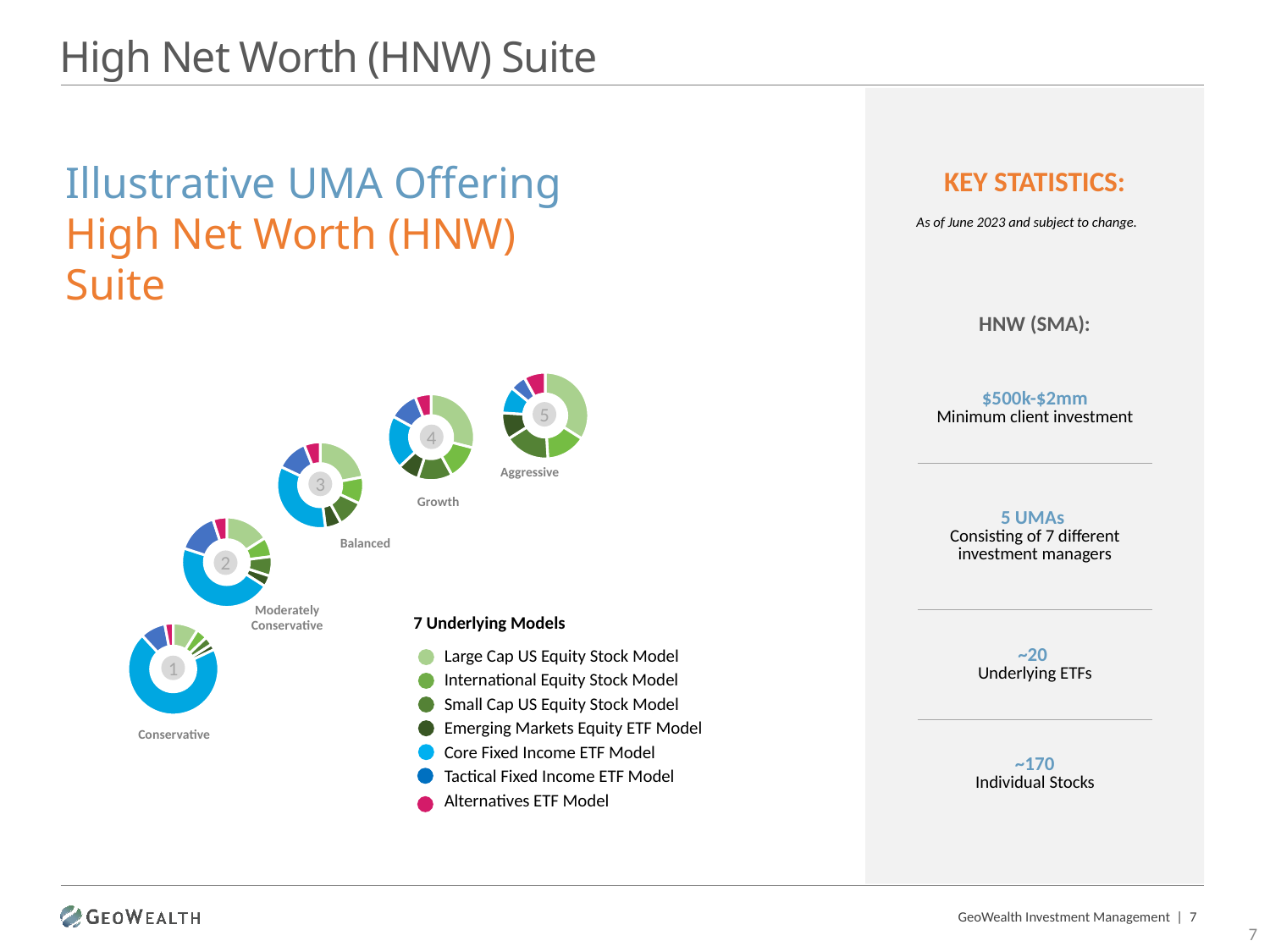
Moving from the Conservative chart to the Aggressive chart, does the share of the Large Cap US Equity Stock Model slice rise or fall? Rise What kind of chart is used to show each of the five portfolio allocations on the slide? Donut (pie) chart What is the label of the donut chart numbered 5? Aggressive In the Moderately Conservative donut chart, which underlying model has the largest slice? Core Fixed Income ETF Model What is the label of the donut chart numbered 1? Conservative In the Aggressive donut chart, which slice is larger: Large Cap US Equity Stock Model or Alternatives ETF Model? Large Cap US Equity Stock Model In the Conservative donut chart, which underlying model has the largest slice? Core Fixed Income ETF Model How many donut charts are shown on the slide? 5 Moving from the Conservative chart to the Aggressive chart, does the share of the Core Fixed Income ETF Model slice rise or fall? Fall How many underlying models does the legend list? 7 In the Aggressive donut chart, which underlying model has the largest slice? Large Cap US Equity Stock Model In the Conservative donut chart, which slice is larger: Core Fixed Income ETF Model or Large Cap US Equity Stock Model? Core Fixed Income ETF Model